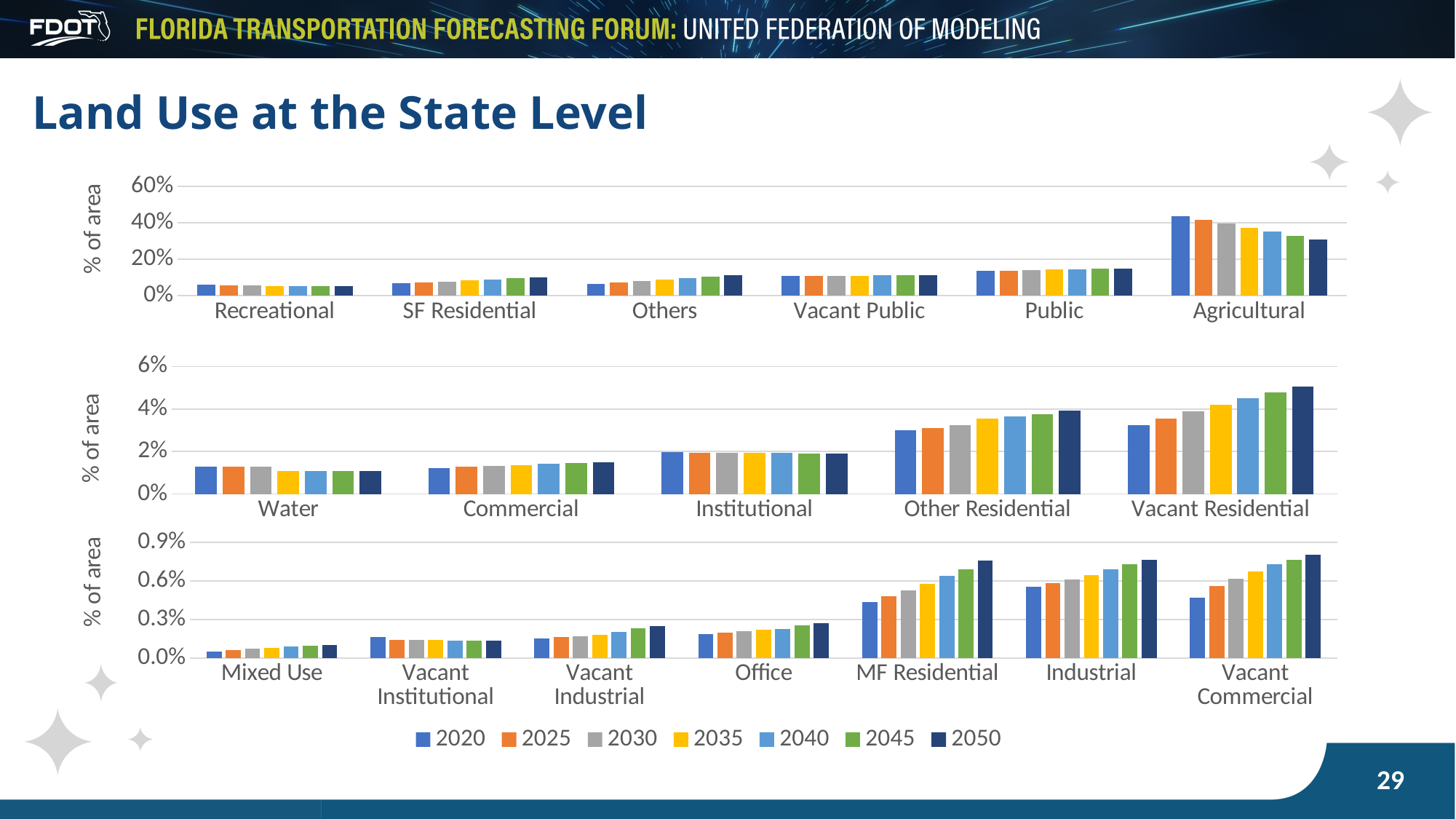
In the top chart, do the Agricultural values rise or fall from 2020 to 2050? fall In the bottom chart, which category has the lowest share of area? Mixed Use What type of chart is used in the top chart on the slide? bar chart In the bottom chart, how many land use categories are shown on the x axis? 7 In the middle chart, which is larger for 2050: Other Residential or Institutional? Other Residential In the top chart, is the 2020 value for Agricultural greater or less than 40%? greater In the middle chart, is the 2050 value for Vacant Residential greater or less than 4%? greater In the bottom chart, do the MF Residential values rise or fall from 2020 to 2050? rise In the top chart, how many land use categories are shown on the x axis? 6 How many series does the legend list? 7 In the middle chart, how many land use categories are shown on the x axis? 5 In the top chart, which category has the highest share of area? Agricultural